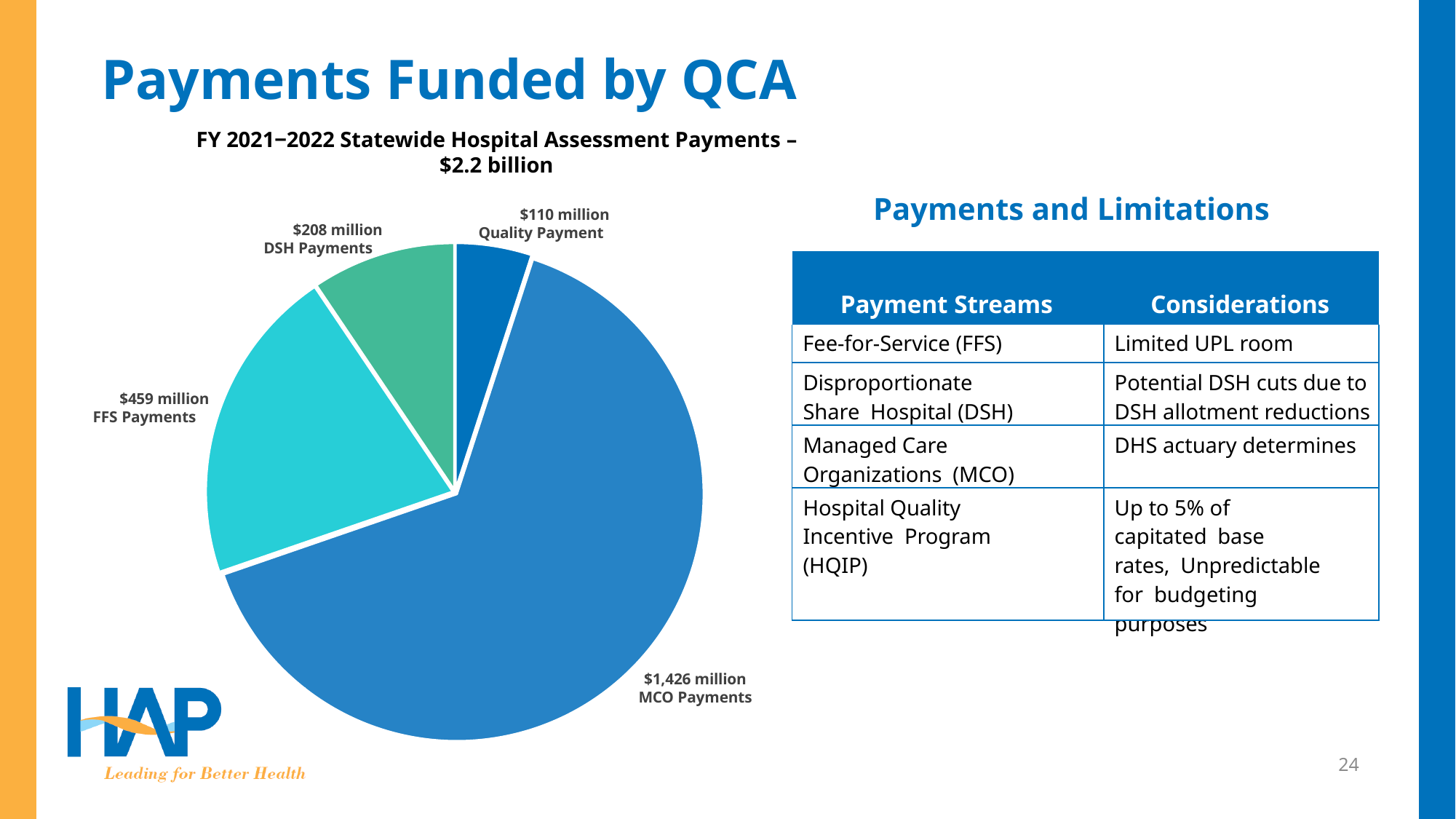
What type of chart is shown on the slide? Pie chart Which is larger, FFS Payments or DSH Payments? FFS Payments Which payment category has the smallest slice of the pie? Quality Payment What is the difference between DSH Payments and Quality Payment? $98 million What is the value of the DSH Payments slice? $208 million What is the value of the FFS Payments slice? $459 million Which payment category has the largest slice of the pie? MCO Payments What is the value of the Quality Payment slice? $110 million How many slices does the pie chart have? 4 What is the difference between MCO Payments and FFS Payments? $967 million What is the title of the pie chart? FY 2021–2022 Statewide Hospital Assessment Payments – $2.2 billion What is the value of the MCO Payments slice? $1,426 million